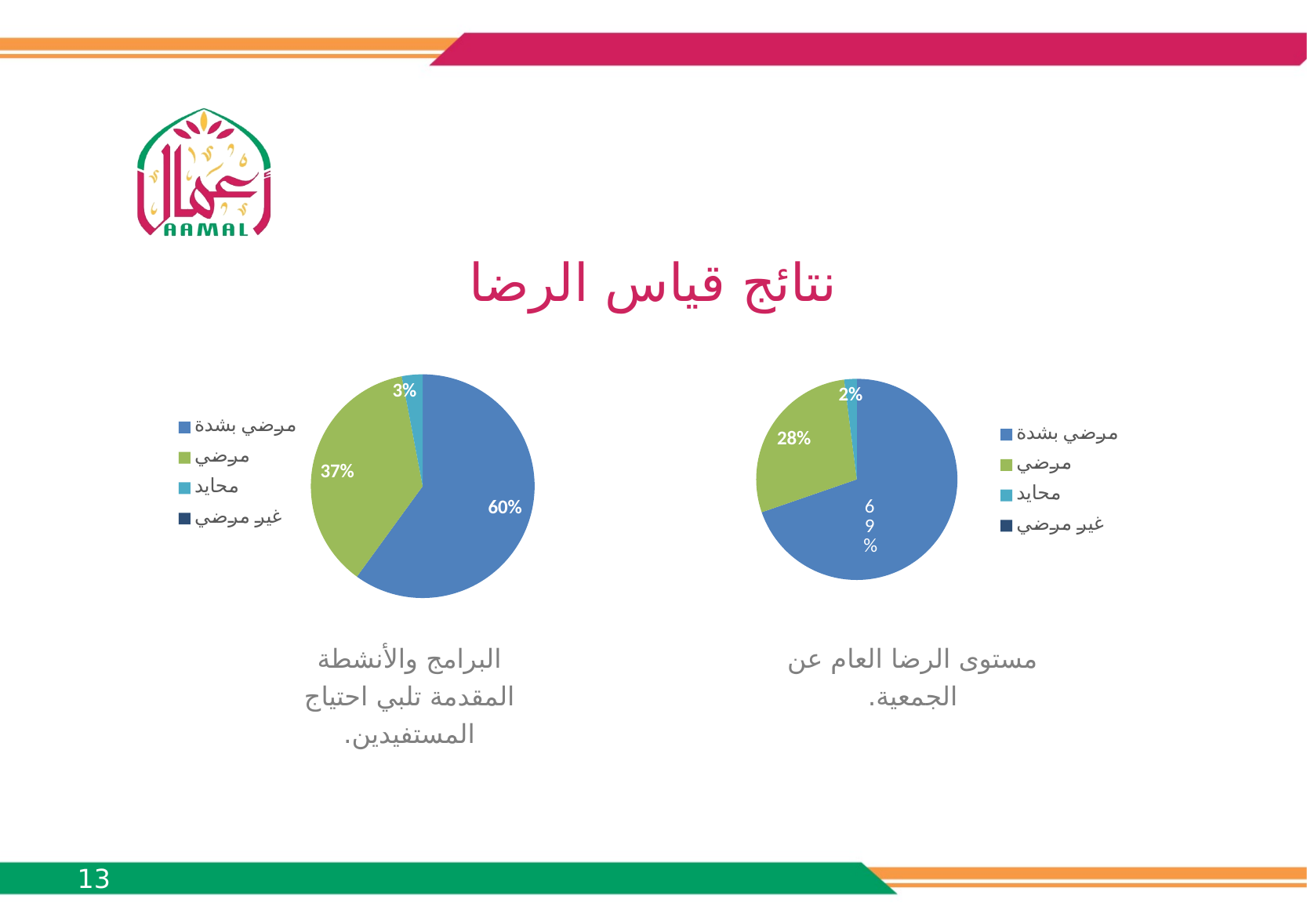
In the right pie chart (مستوى الرضا العام عن الجمعية), what is the share for محايد? 2% How many entries does the legend of the right pie chart (مستوى الرضا العام عن الجمعية) list? 4 What type of chart is used on the left side of the slide? pie chart In the left pie chart (البرامج والأنشطة المقدمة تلبي احتياج المستفيدين), what is the share for مرضي? 37% In the right pie chart (مستوى الرضا العام عن الجمعية), what is the share for مرضي? 28% In the right pie chart (مستوى الرضا العام عن الجمعية), which category has the largest slice? مرضي بشدة Which chart has the larger share for مرضي بشدة, the left chart or the right chart? the right chart In the right pie chart (مستوى الرضا العام عن الجمعية), what is the share for مرضي بشدة? 69% In the left pie chart (البرامج والأنشطة المقدمة تلبي احتياج المستفيدين), what is the share for محايد? 3% In the left pie chart (البرامج والأنشطة المقدمة تلبي احتياج المستفيدين), what is the share for مرضي بشدة? 60% In the left pie chart (البرامج والأنشطة المقدمة تلبي احتياج المستفيدين), which labelled category has the smallest slice? محايد In the left pie chart (البرامج والأنشطة المقدمة تلبي احتياج المستفيدين), what is the difference between the shares for مرضي بشدة and مرضي? 23%